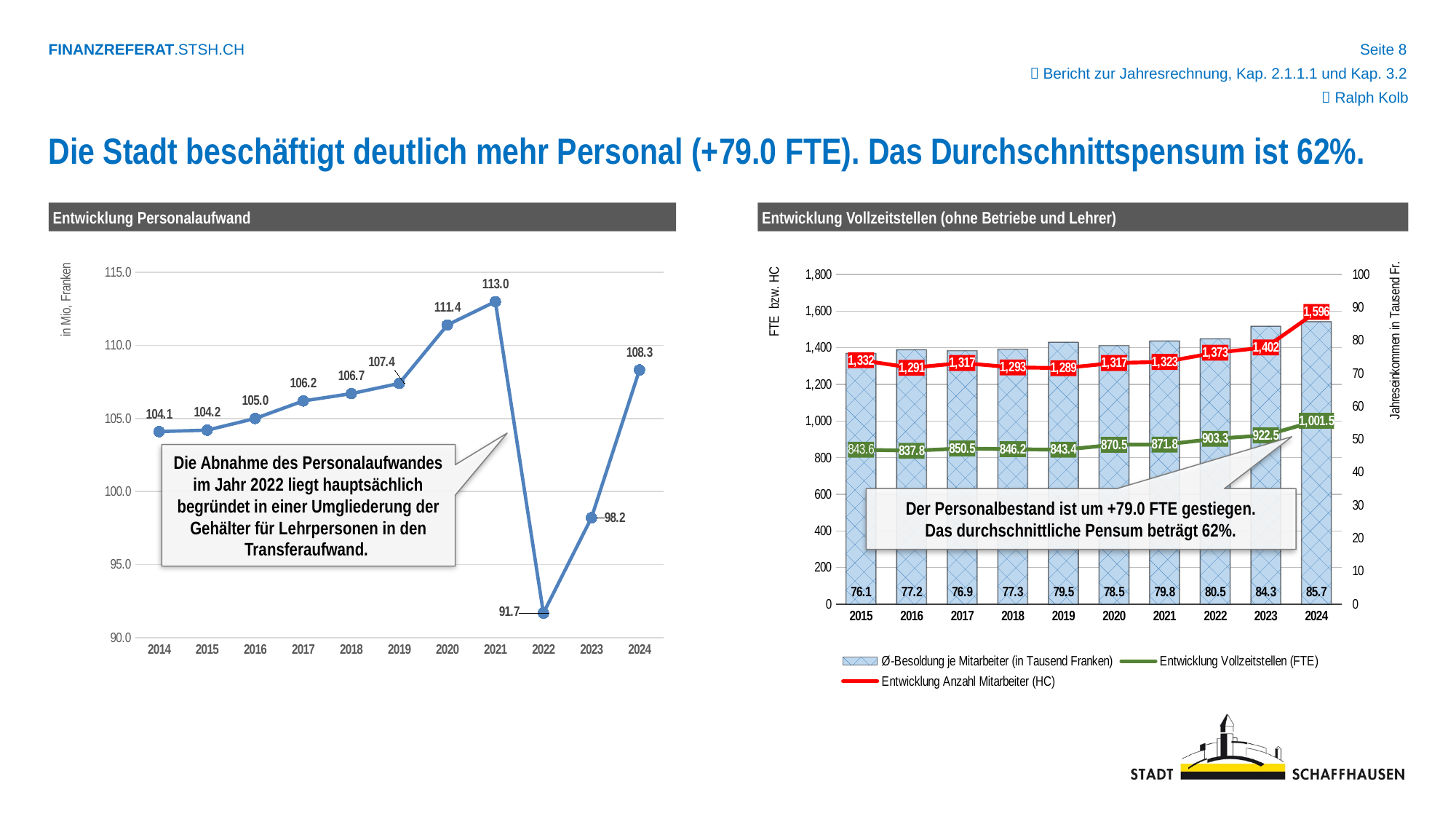
In the 'Entwicklung Vollzeitstellen (ohne Betriebe und Lehrer)' chart, how many series does the legend list? 3 In the 'Entwicklung Vollzeitstellen (ohne Betriebe und Lehrer)' chart, which is larger: the 'Entwicklung Anzahl Mitarbeiter (HC)' value for 2024 or for 2015? 2024 In the 'Entwicklung Personalaufwand' chart, how many years are plotted on the x axis? 11 In the 'Entwicklung Personalaufwand' chart, which year has the highest value? 2021 In the 'Entwicklung Personalaufwand' chart, which year has the lowest value? 2022 In the 'Entwicklung Vollzeitstellen (ohne Betriebe und Lehrer)' chart, what is the 'Ø-Besoldung je Mitarbeiter' value for 2023? 84.3 In the 'Entwicklung Personalaufwand' chart, what is the value for 2021? 113.0 In the 'Entwicklung Vollzeitstellen (ohne Betriebe und Lehrer)' chart, what is the value of 'Entwicklung Anzahl Mitarbeiter (HC)' for 2019? 1,289 In the 'Entwicklung Vollzeitstellen (ohne Betriebe und Lehrer)' chart, what is the value of 'Entwicklung Vollzeitstellen (FTE)' for 2024? 1,001.5 In the 'Entwicklung Personalaufwand' chart, what is the difference between the 2021 value and the 2022 value? 21.3 In the 'Entwicklung Personalaufwand' chart, do the values rise or fall from 2014 to 2021? rise In the 'Entwicklung Vollzeitstellen (ohne Betriebe und Lehrer)' chart, what is the difference between the 'Entwicklung Vollzeitstellen (FTE)' values for 2024 and 2023? 79.0